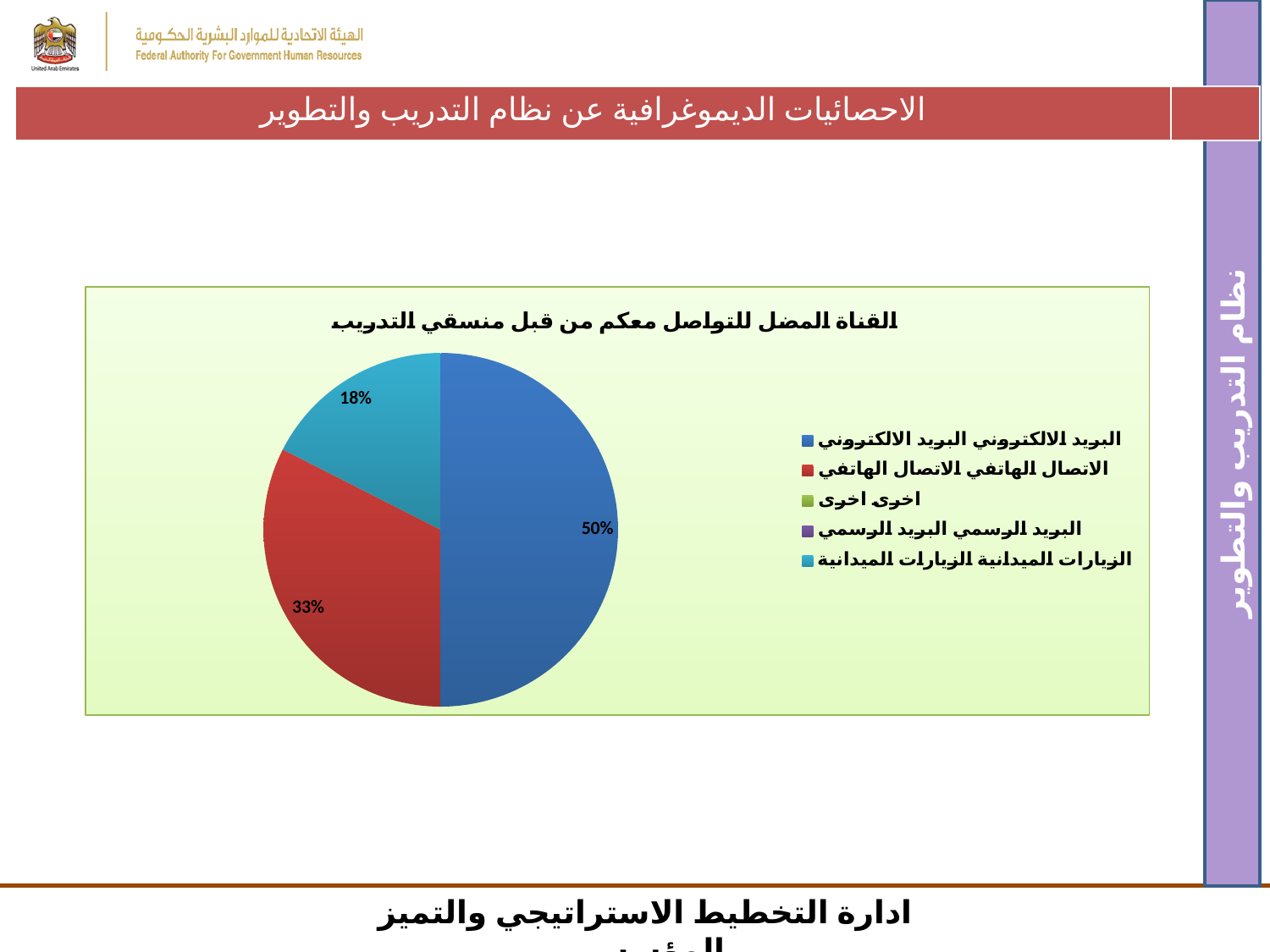
Which of the labelled slices has the smallest share of the pie? الزيارات الميدانية What is the difference in percentage points between the share for البريد الالكتروني and the share for الاتصال الهاتفي? 17 percentage points What colour is the slice for البريد الالكتروني? Blue What percentage of the pie is the slice for الزيارات الميدانية (field visits)? 18% How many entries does the legend list? 5 What kind of chart is shown on the slide? Pie chart What percentage of the pie is the slice for الاتصال الهاتفي (phone call)? 33% Which category has the largest share of the pie? البريد الالكتروني What is the title of the pie chart? القناة المضل للتواصل معكم من قبل منسقي التدريب How many slices with a printed percentage label are visible in the pie? 3 What percentage of the pie is the slice for البريد الالكتروني (email)? 50% Which is larger: the share for الاتصال الهاتفي or the share for الزيارات الميدانية? الاتصال الهاتفي